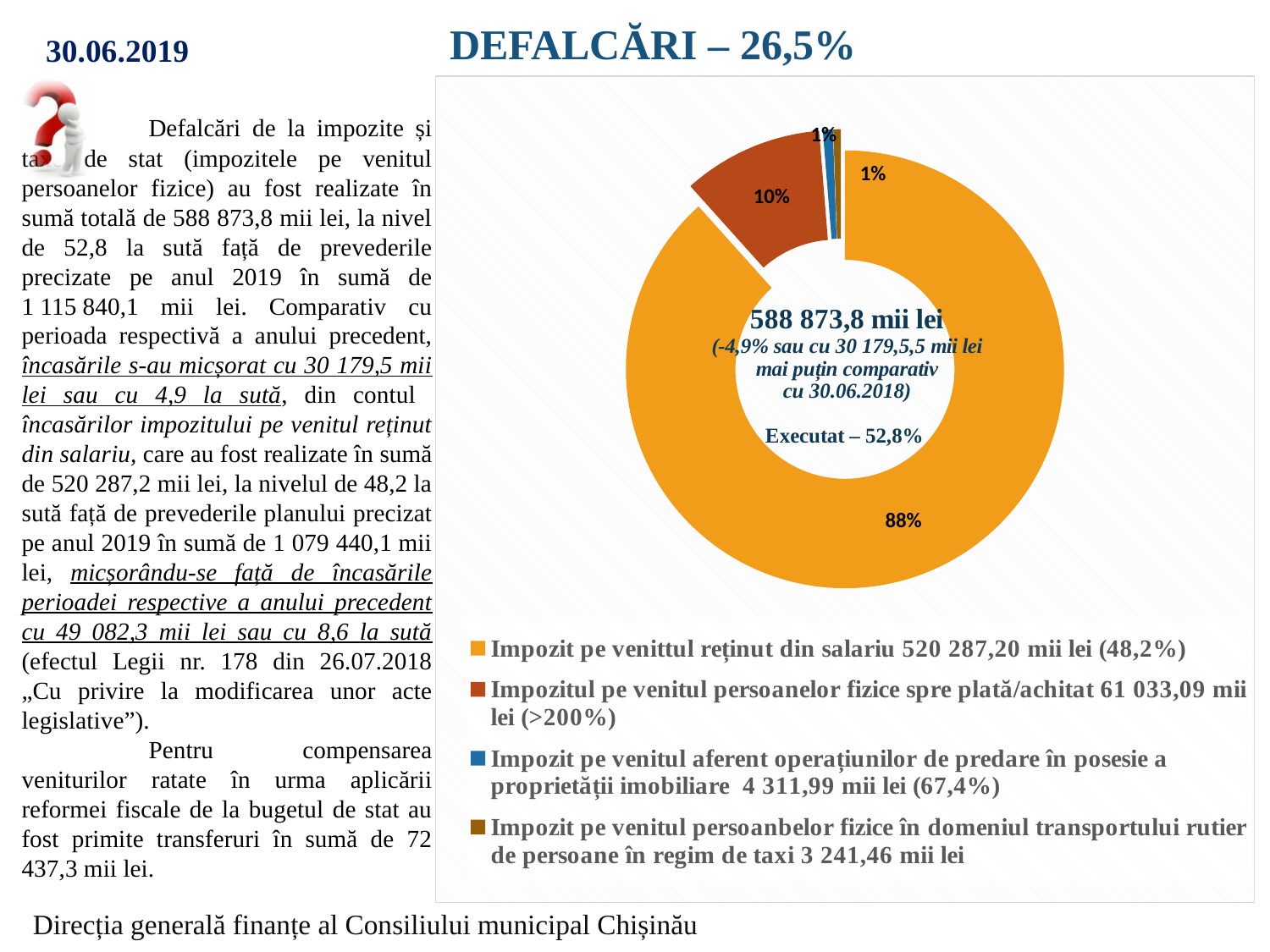
According to the legend, what is the value for 'Impozit pe venitul aferent operațiunilor de predare în posesie a proprietății imobiliare'? 4 311,99 mii lei According to the legend, what is the value for 'Impozitul pe venitul persoanelor fizice spre plată/achitat'? 61 033,09 mii lei Based on the values in the legend, which category has the smallest value? Impozit pe venitul persoanbelor fizice în domeniul transportului rutier de persoane în regim de taxi According to the legend, what is the value for the taxi transport income tax category ('Impozit pe venitul persoanbelor fizice în domeniul transportului rutier de persoane în regim de taxi')? 3 241,46 mii lei How many slices does the pie chart have? 4 What total amount is printed in the centre of the pie chart? 588 873,8 mii lei What share of the pie does 'Impozit pe venittul reținut din salariu' represent? 88% What share of the pie does 'Impozitul pe venitul persoanelor fizice spre plată/achitat' represent? 10% What is the difference in percentage points between the 'Impozit pe venittul reținut din salariu' slice and the 'Impozitul pe venitul persoanelor fizice spre plată/achitat' slice? 78 percentage points What kind of chart is shown on the slide? doughnut chart According to the legend, what is the value for 'Impozit pe venittul reținut din salariu'? 520 287,20 mii lei Which category has the largest slice of the pie? Impozit pe venittul reținut din salariu